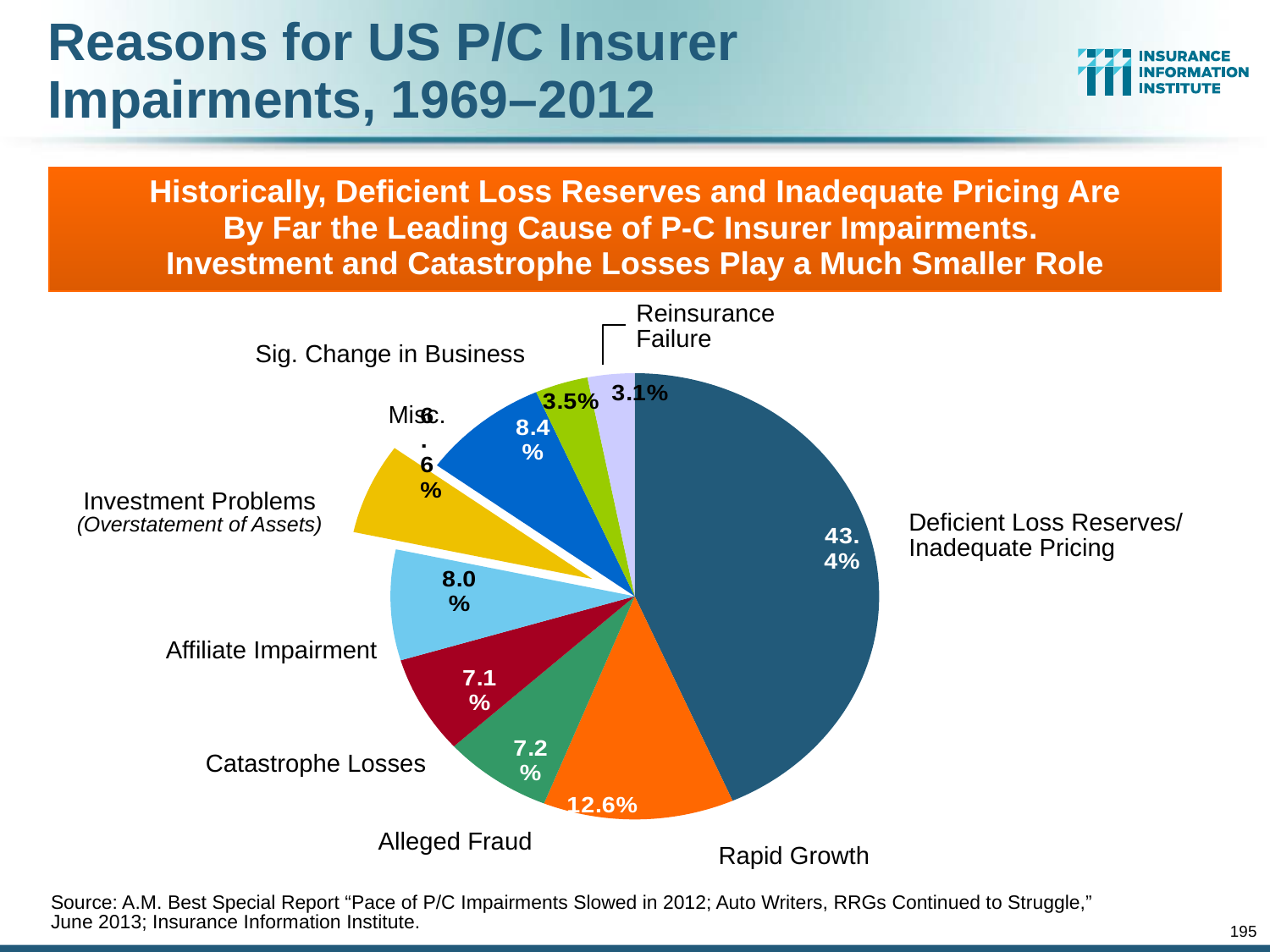
What percentage of impairments is attributed to Reinsurance Failure? 3.1% What share of US P/C insurer impairments is attributed to Deficient Loss Reserves/Inadequate Pricing? 43.4% What kind of chart is shown on the slide? Pie chart Which reason accounts for the smallest share of impairments? Reinsurance Failure What percentage of impairments is attributed to Sig. Change in Business? 3.5% What percentage of impairments is attributed to Alleged Fraud? 7.2% What percentage of impairments is attributed to Affiliate Impairment? 8.0% How many reasons (slices) are shown in the pie chart? 9 What percentage of impairments is attributed to Catastrophe Losses? 7.1% Which reason accounts for the largest share of impairments? Deficient Loss Reserves/Inadequate Pricing How many percentage points larger is the Rapid Growth share than the Alleged Fraud share? 5.4% What percentage of impairments is attributed to Rapid Growth? 12.6%